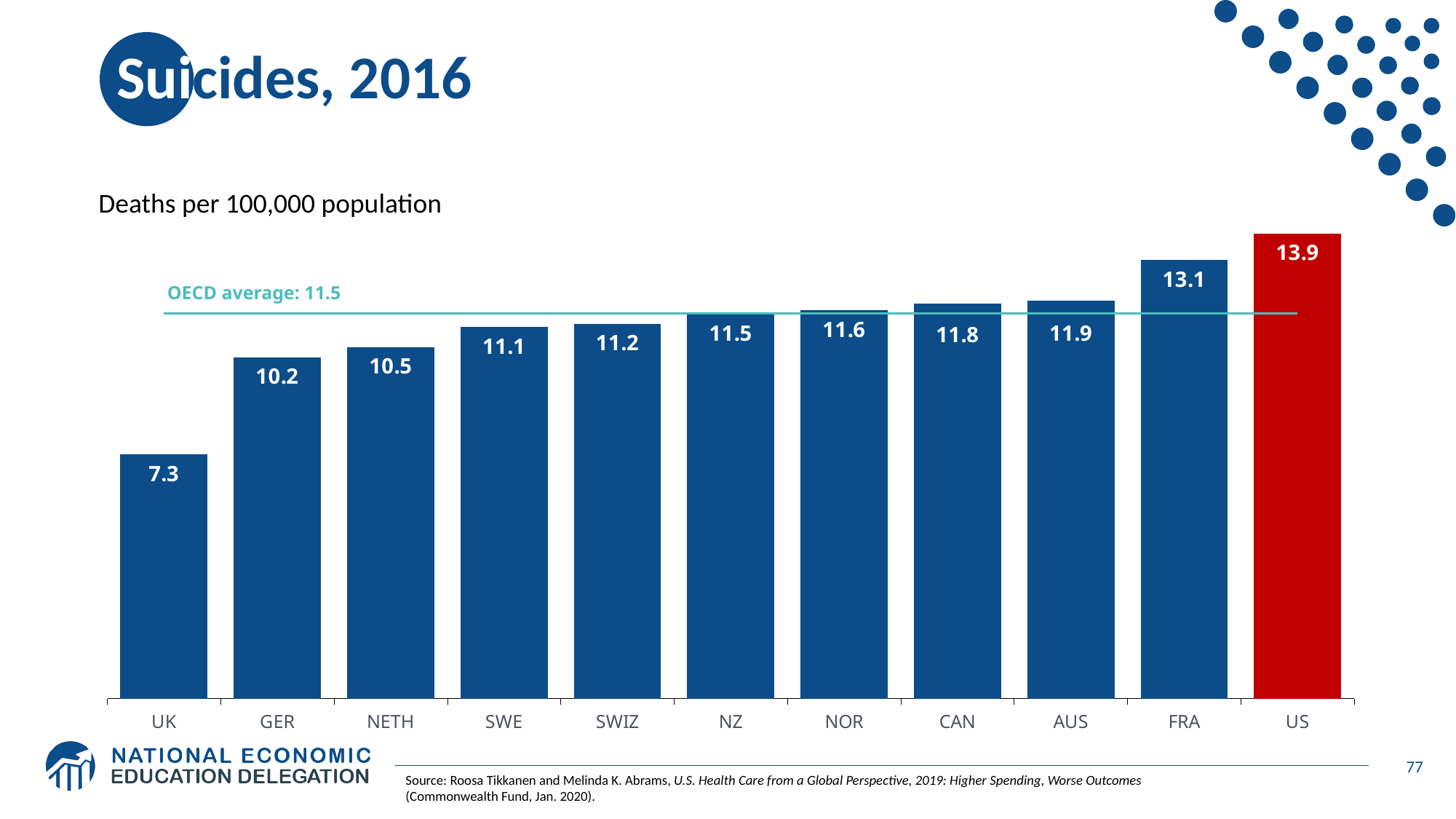
Do the values rise or fall moving from left to right along the x axis? Rise Which has a higher value, SWE or NETH? SWE Which country has the highest suicide rate on the chart? US What is the value shown for NOR? 11.6 What is the suicide rate (deaths per 100,000 population) for the US? 13.9 What is the difference between the US value and the UK value? 6.6 What is the difference between the FRA value and the AUS value? 1.2 Which country has the lowest suicide rate on the chart? UK What is the value shown for GER? 10.2 What OECD average value is marked by the horizontal line on the chart? 11.5 What type of chart is shown on the slide? Bar chart How many countries are shown on the chart? 11